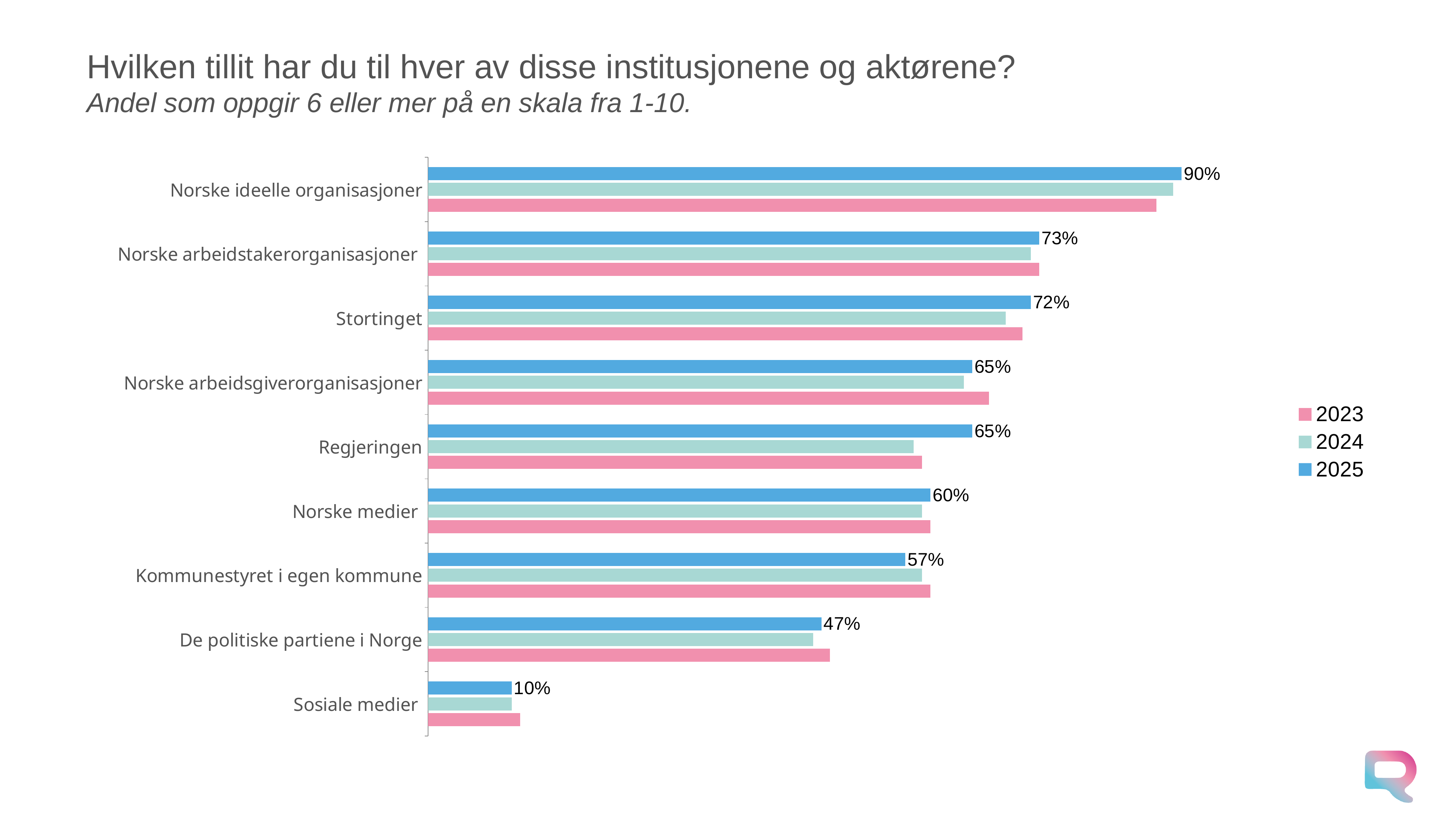
For Norske ideelle organisasjoner, which year has the larger value, 2023 or 2025? 2025 What is the 2025 value for Stortinget? 72% What is the difference between the 2025 values for Norske arbeidstakerorganisasjoner and Kommunestyret i egen kommune? 16% Which category has the highest 2025 value? Norske ideelle organisasjoner How many series does the legend list? 3 Which legend entry is shown in pink? 2023 Which category has the lowest 2025 value? Sosiale medier How many institutions or actors are listed on the chart? 9 What is the 2025 value for De politiske partiene i Norge? 47% What kind of chart is shown on the slide? bar chart What is the 2025 value for Sosiale medier? 10% What is the 2025 value for Norske ideelle organisasjoner? 90%